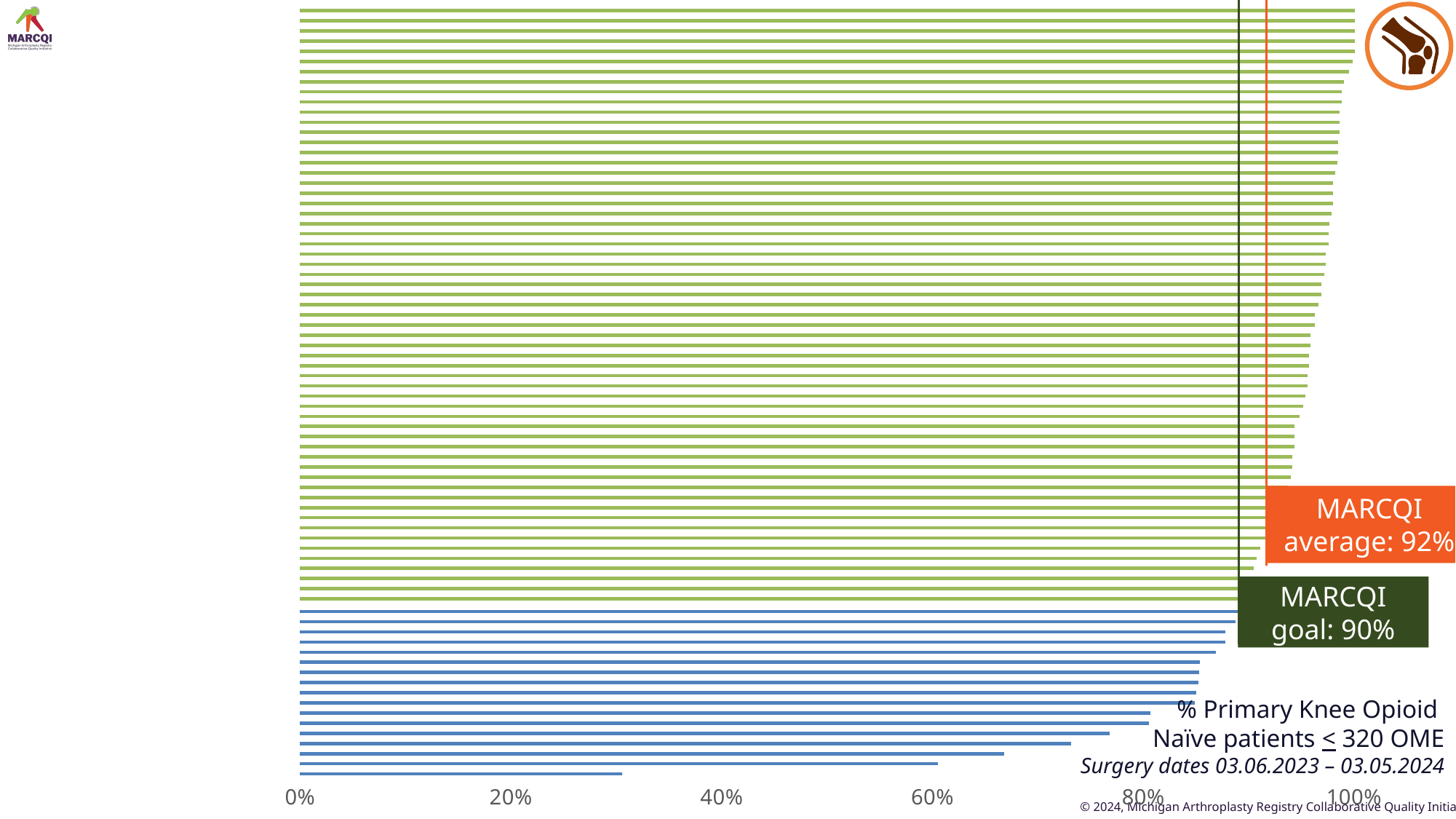
What is the title of the chart? % Primary Knee Opioid Naïve patients ≤ 320 OME What colour are the bars that fall below the MARCQI goal? blue What is the MARCQI average shown on the chart? 92% By how many percentage points does the MARCQI average exceed the MARCQI goal? 2% Is the value of the longest bar at the top of the chart greater or less than 80%? greater Do the bar values rise or fall going from the top of the chart to the bottom? fall What kind of chart is shown on the slide? bar chart What is the MARCQI goal shown on the chart? 90% What is the highest value shown on the x axis? 100% Is the value of the shortest bar at the bottom of the chart greater or less than 40%? less Is the MARCQI average greater or less than the MARCQI goal? greater